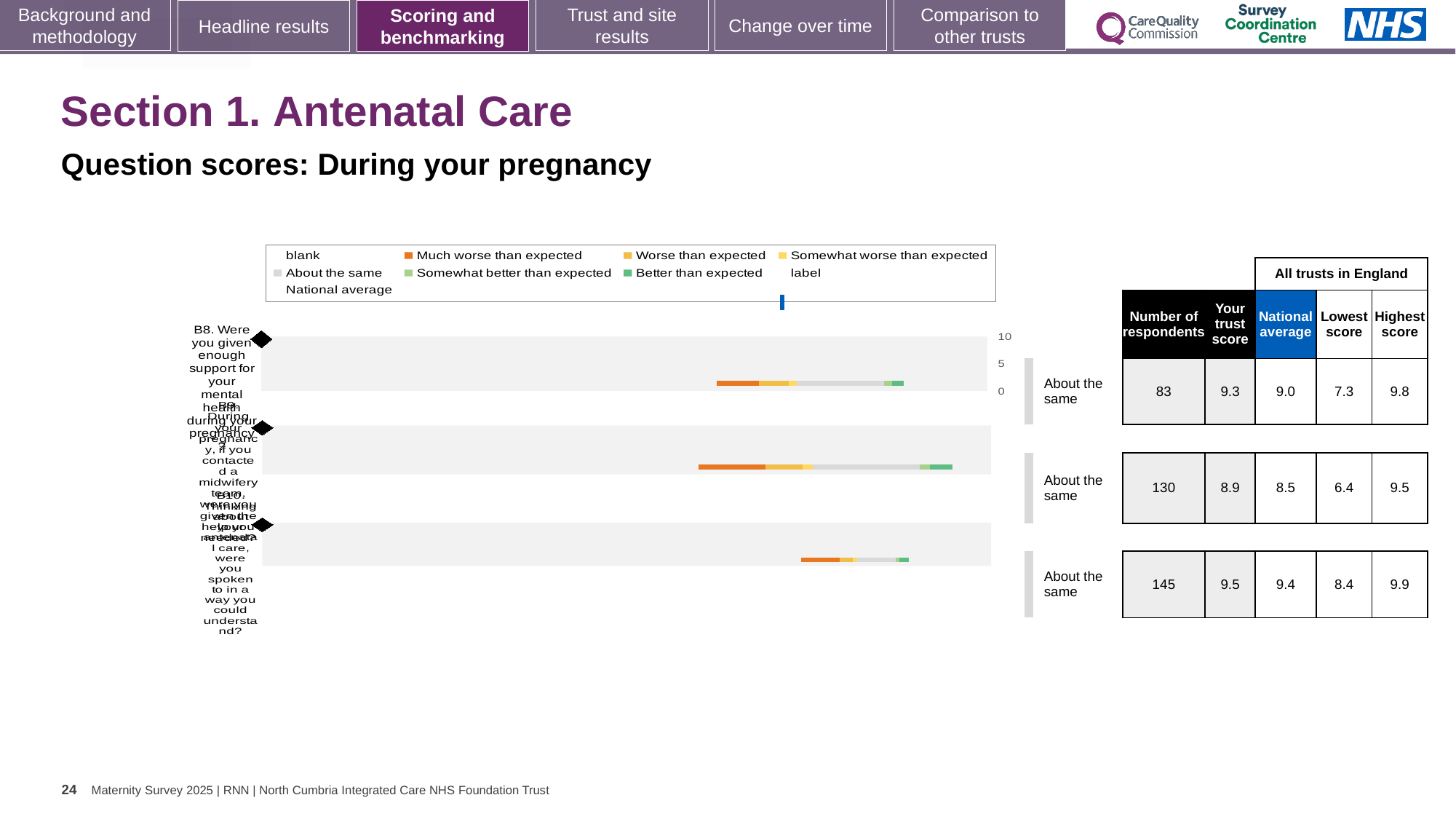
What kind of chart is shown on the slide? bar chart According to the table beside the chart, what is the lowest score among all trusts in England for the middle row? 6.4 What benchmark category is shown next to each of the three bars? About the same Which row has the lowest trust score in the table beside the chart? the middle row (8.9) What is the difference between the highest score and the lowest score for the top row in the table beside the chart? 2.5 Is the trust score for the bottom row larger or smaller than its national average? larger According to the table beside the chart, what is the number of respondents for the top row? 83 Which row has the highest number of respondents in the table beside the chart? the bottom row (145) What is the heading above the National average, Lowest score and Highest score columns in the table beside the chart? All trusts in England According to the table beside the chart, what is the national average for the bottom row? 9.4 According to the table beside the chart, what is the trust score for the middle row? 8.9 How many question rows (bars) does the chart show? 3